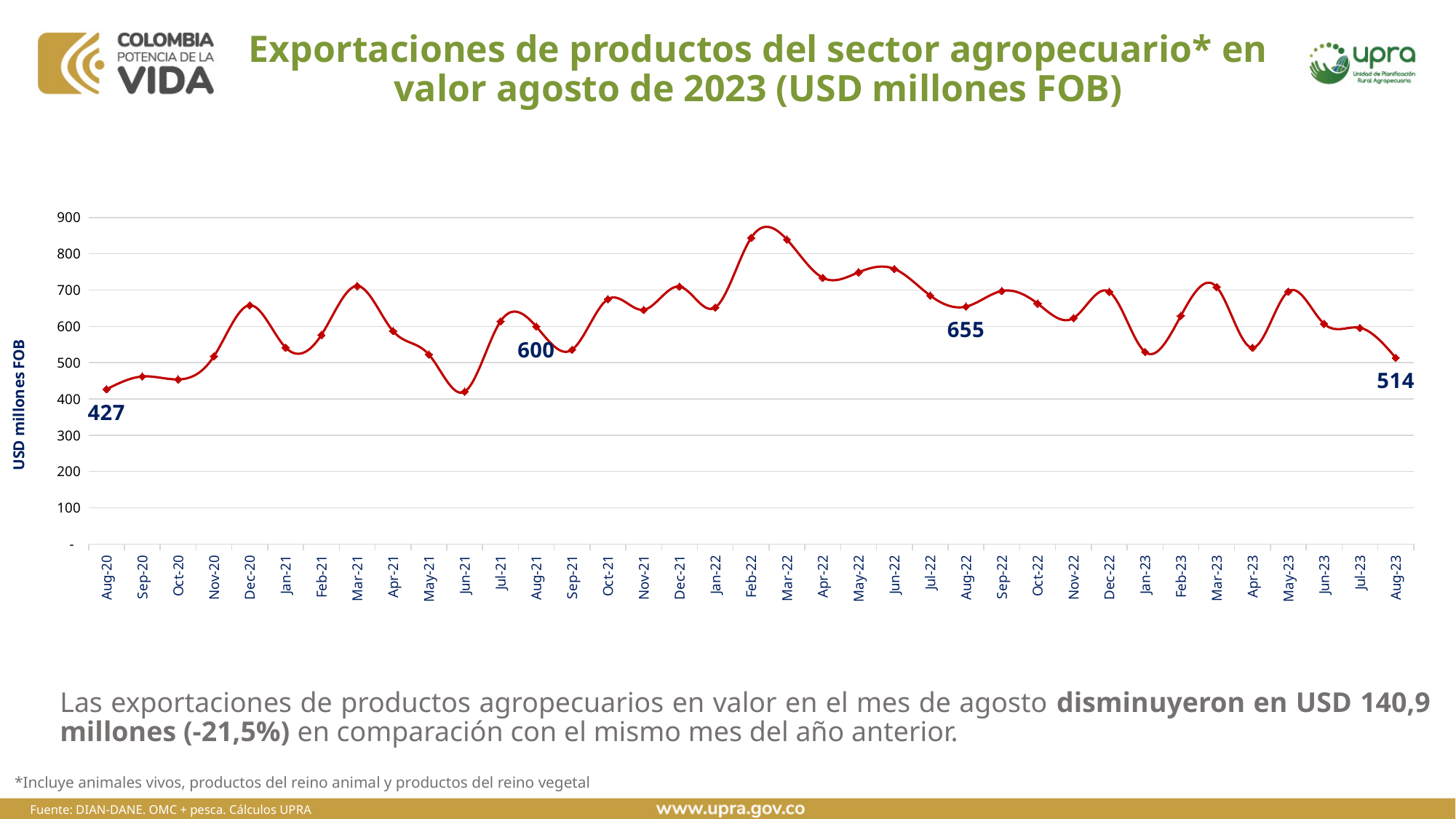
Which month has the highest value on the chart? Feb-22 What is the value for Aug-20? 427 Which is larger, the value for Aug-21 or the value for Aug-20? Aug-21 Is the value for Jun-21 greater or less than 500? less Is the value for Feb-22 greater or less than 800? greater What is the value for Aug-21? 600 What is the value for Aug-23? 514 How many monthly data points are plotted on the chart? 37 What kind of chart is shown on the slide? line chart What is the difference between the values for Aug-22 and Aug-23? 141 What is the title of the vertical axis? USD millones FOB What is the value for Aug-22? 655